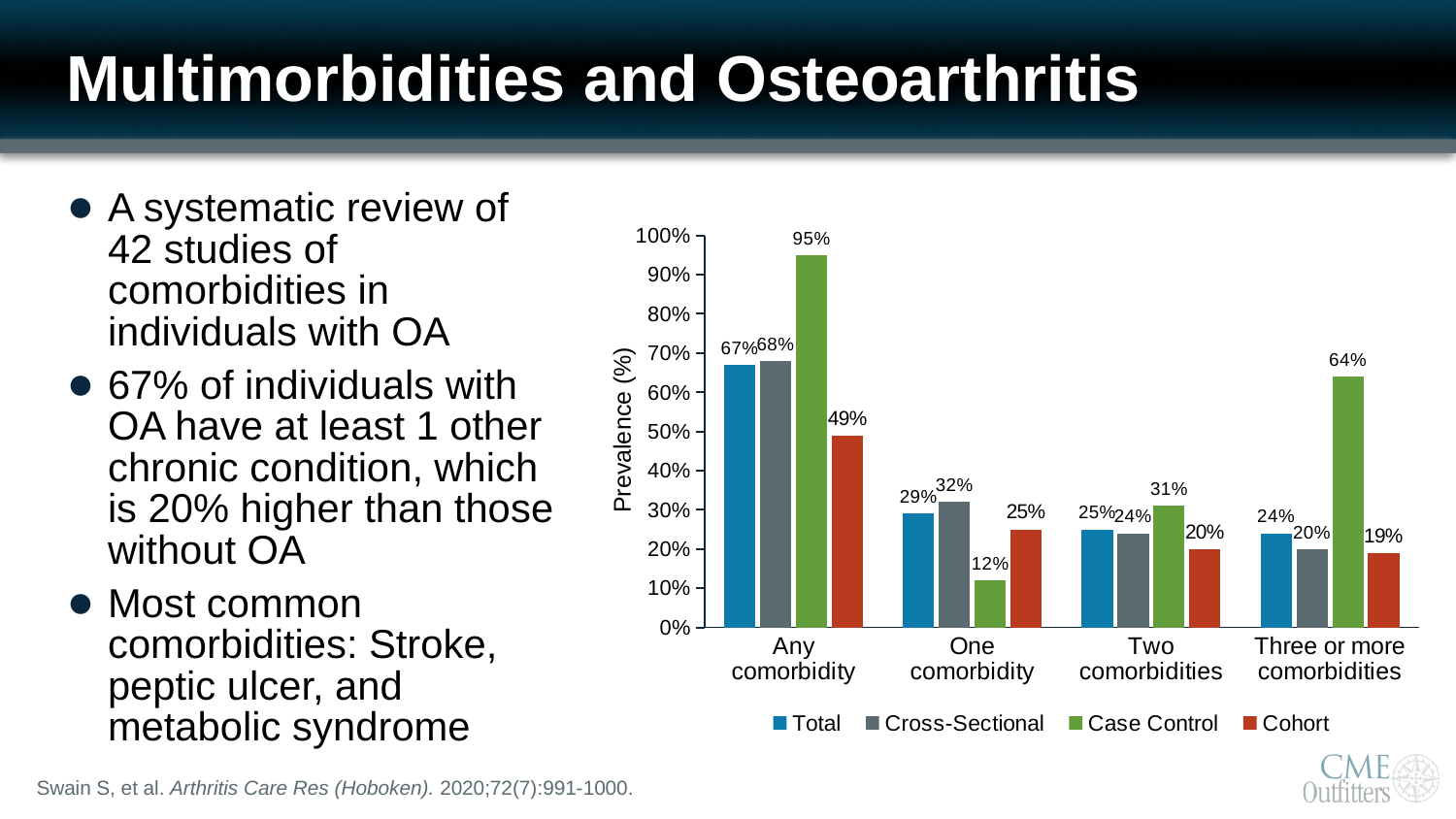
Which series has the highest value for Two comorbidities? Case Control What is the Case Control value for Any comorbidity? 95% What is the label of the y axis? Prevalence (%) Which is larger for Three or more comorbidities: the Total value or the Cross-Sectional value? Total How many comorbidity categories are shown on the x axis? 4 Does the Total series rise or fall from Any comorbidity to Three or more comorbidities? Fall What is the Cohort value for Three or more comorbidities? 19% Which series has the lowest value for One comorbidity? Case Control What is the Total value for One comorbidity? 29% What is the difference between the Case Control and Cohort values for Any comorbidity? 46% How many series does the legend list? 4 What kind of chart is shown on the slide? Bar chart